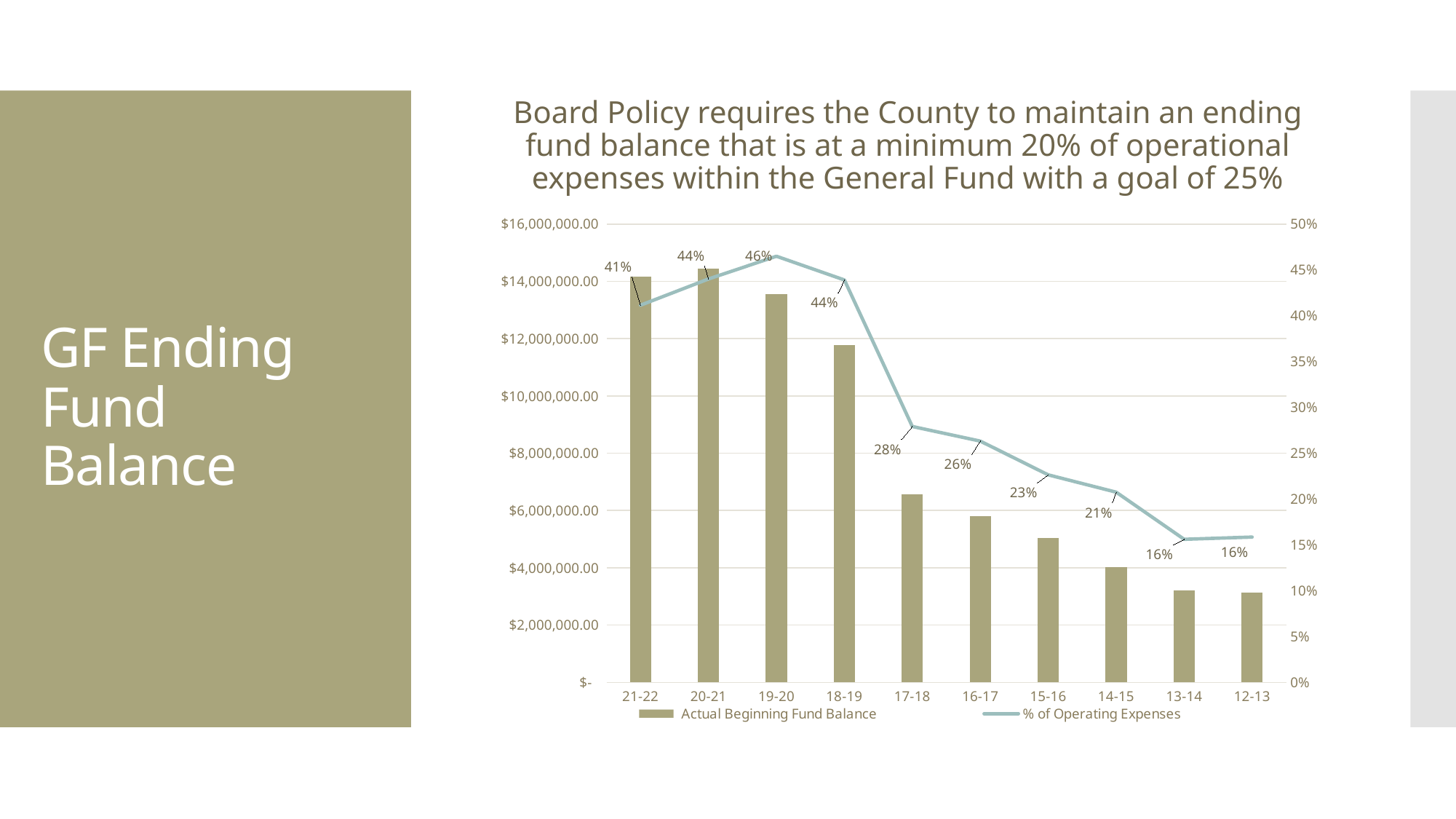
What kind of chart is shown on the slide? Combination bar and line chart How many fiscal years are shown on the x axis? 10 What is the difference in percentage points between the % of Operating Expenses for 19-20 and 21-22? 5 percentage points Which year has the highest % of Operating Expenses? 19-20 Is the Actual Beginning Fund Balance for 17-18 greater or less than $8,000,000.00? less Is the Actual Beginning Fund Balance for 18-19 greater or less than $10,000,000.00? greater What is the % of Operating Expenses value for 19-20? 46% What is the % of Operating Expenses value for 17-18? 28% Which year has the highest Actual Beginning Fund Balance bar? 20-21 What is the % of Operating Expenses value for 21-22? 41% Which is larger, the % of Operating Expenses for 17-18 or for 15-16? 17-18 How many series does the legend list? 2